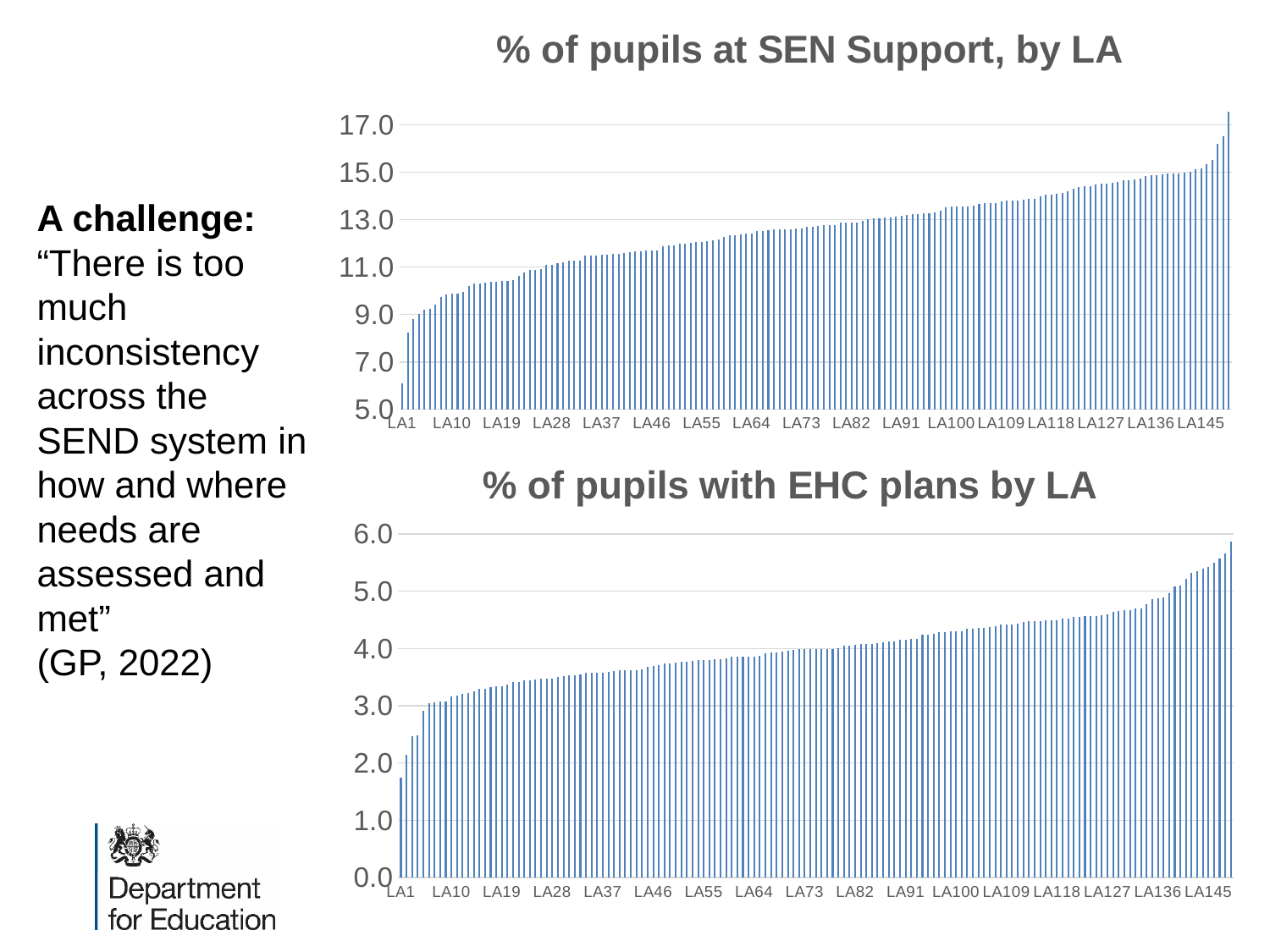
In the '% of pupils at SEN Support, by LA' chart, is the value for LA10 greater or less than 9.0? greater In the '% of pupils at SEN Support, by LA' chart, is the value for LA73 greater or less than 11.0? greater In the '% of pupils with EHC plans by LA' chart, is the value for LA145 greater or less than 5.0? greater In the '% of pupils at SEN Support, by LA' chart, do the values rise or fall from LA1 to LA145? rise In the '% of pupils with EHC plans by LA' chart, do the values rise or fall along the x axis? rise What is the title of the lower chart on the slide? % of pupils with EHC plans by LA What type of chart is '% of pupils at SEN Support, by LA'? bar chart What type of chart is '% of pupils with EHC plans by LA'? bar chart In the '% of pupils at SEN Support, by LA' chart, which is larger, the value for LA1 or the value for LA145? LA145